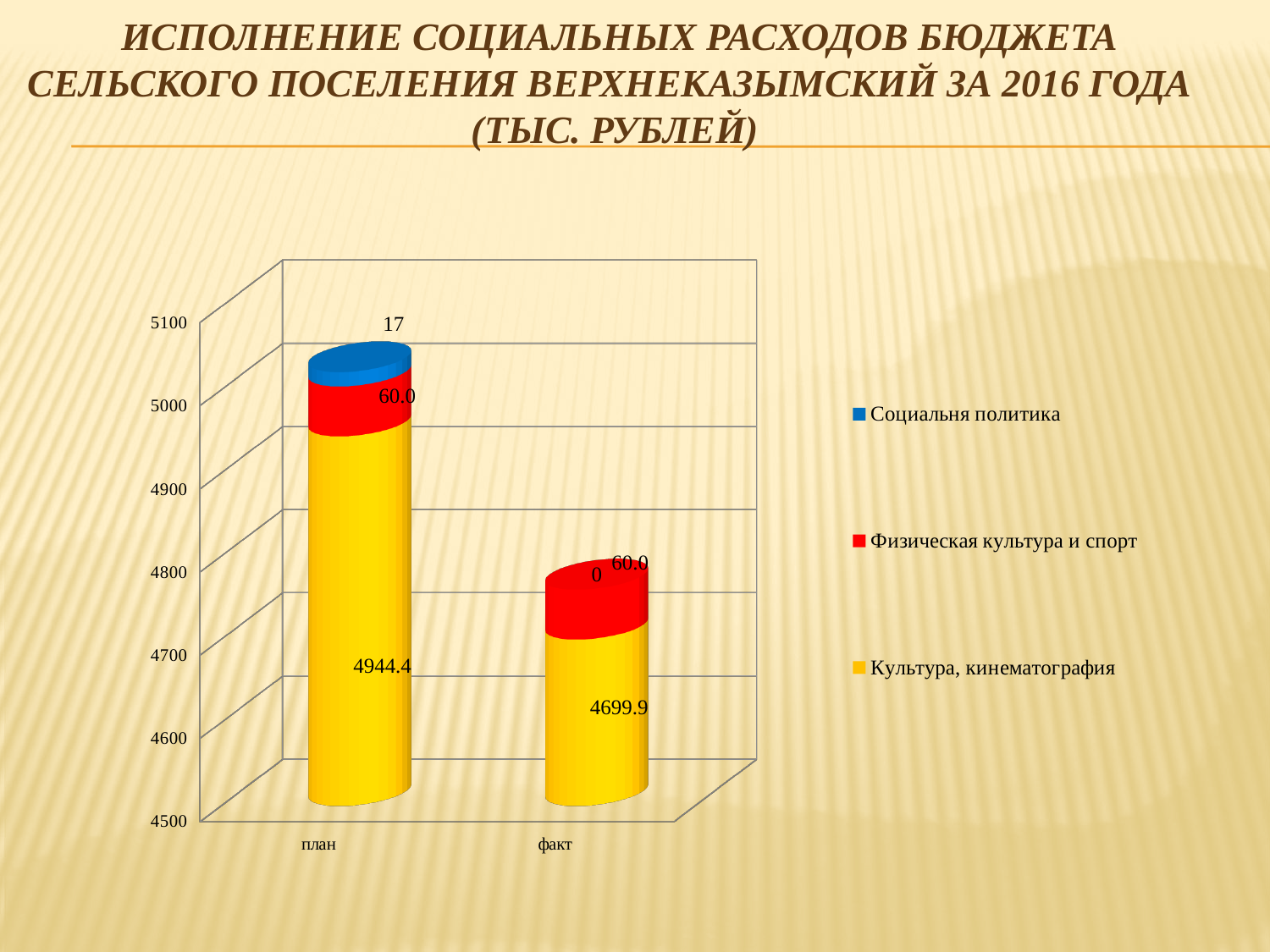
What kind of chart is shown on the slide? stacked bar chart What is the total of the stacked bar for факт? 4759.9 How many series does the legend list? 3 Which category has the larger Культура, кинематография value, план or факт? план What is the difference between the Культура, кинематография values for план and факт? 244.5 What is the total of the stacked bar for план? 5021.4 What is the value of Социальня политика for план? 17 What is the value of Физическая культура и спорт for факт? 60.0 What is the value of Социальня политика for факт? 0 How many categories are shown on the x axis? 2 What is the value of Культура, кинематография for план? 4944.4 What is the value of Культура, кинематография for факт? 4699.9